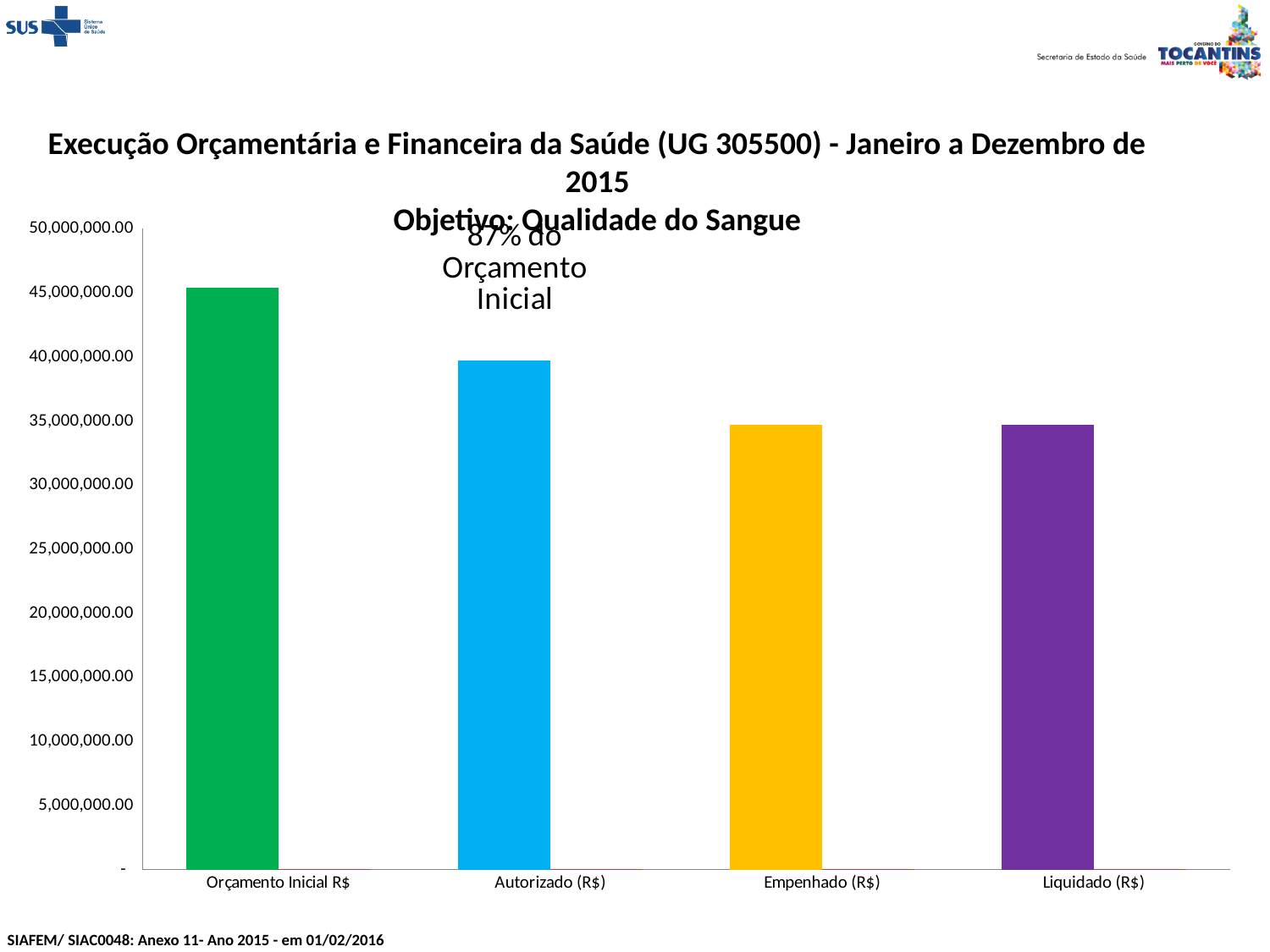
What colour is the bar for Autorizado (R$)? blue Which is larger, Autorizado (R$) or Empenhado (R$)? Autorizado (R$) Is the value for Autorizado (R$) greater or less than 35,000,000.00? greater Is the value for Orçamento Inicial R$ greater or less than 40,000,000.00? greater Which is larger, Orçamento Inicial R$ or Autorizado (R$)? Orçamento Inicial R$ What kind of chart is shown on the slide? bar chart Do the values generally rise or fall from left to right across the categories? fall Is the value for Empenhado (R$) greater or less than 30,000,000.00? greater Which category has the highest value? Orçamento Inicial R$ What percentage of the Orçamento Inicial does the annotation on the chart state? 87% How many categories are plotted on the chart? 4